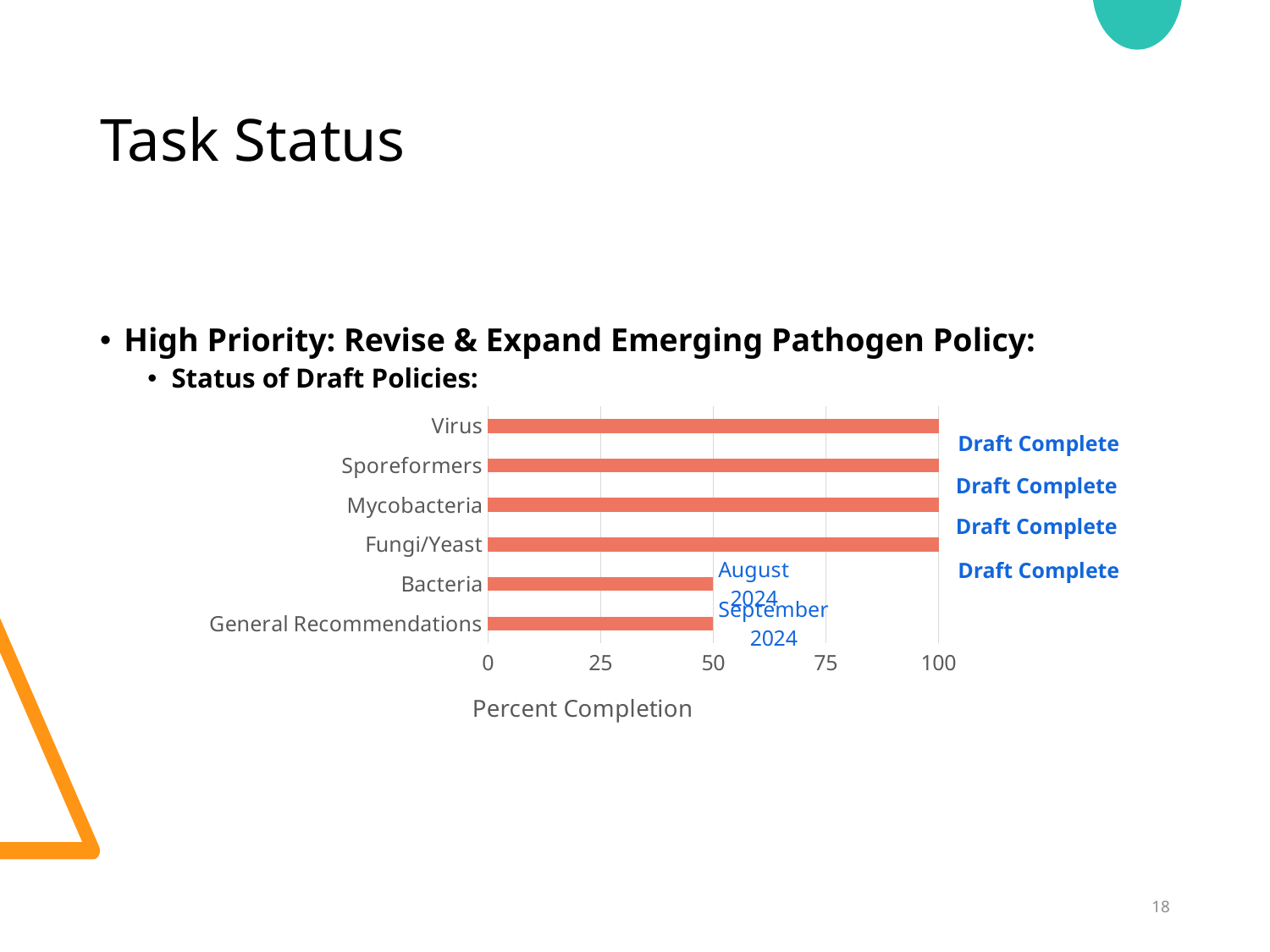
How many categories are plotted in the chart? 6 Is the value for Bacteria greater or less than 75? less What is the percent completion for Fungi/Yeast? 100 Is the value for Sporeformers greater or less than 75? greater Which is larger, the value for Mycobacteria or the value for Bacteria? Mycobacteria What is the percent completion for Virus? 100 What is the title of the horizontal axis? Percent Completion What is the difference between the percent completion for Sporeformers and for General Recommendations? 50 What kind of chart is shown on the slide? bar chart What is the percent completion for General Recommendations? 50 What is the percent completion for Bacteria? 50 What status label is written next to the Virus bar? Draft Complete